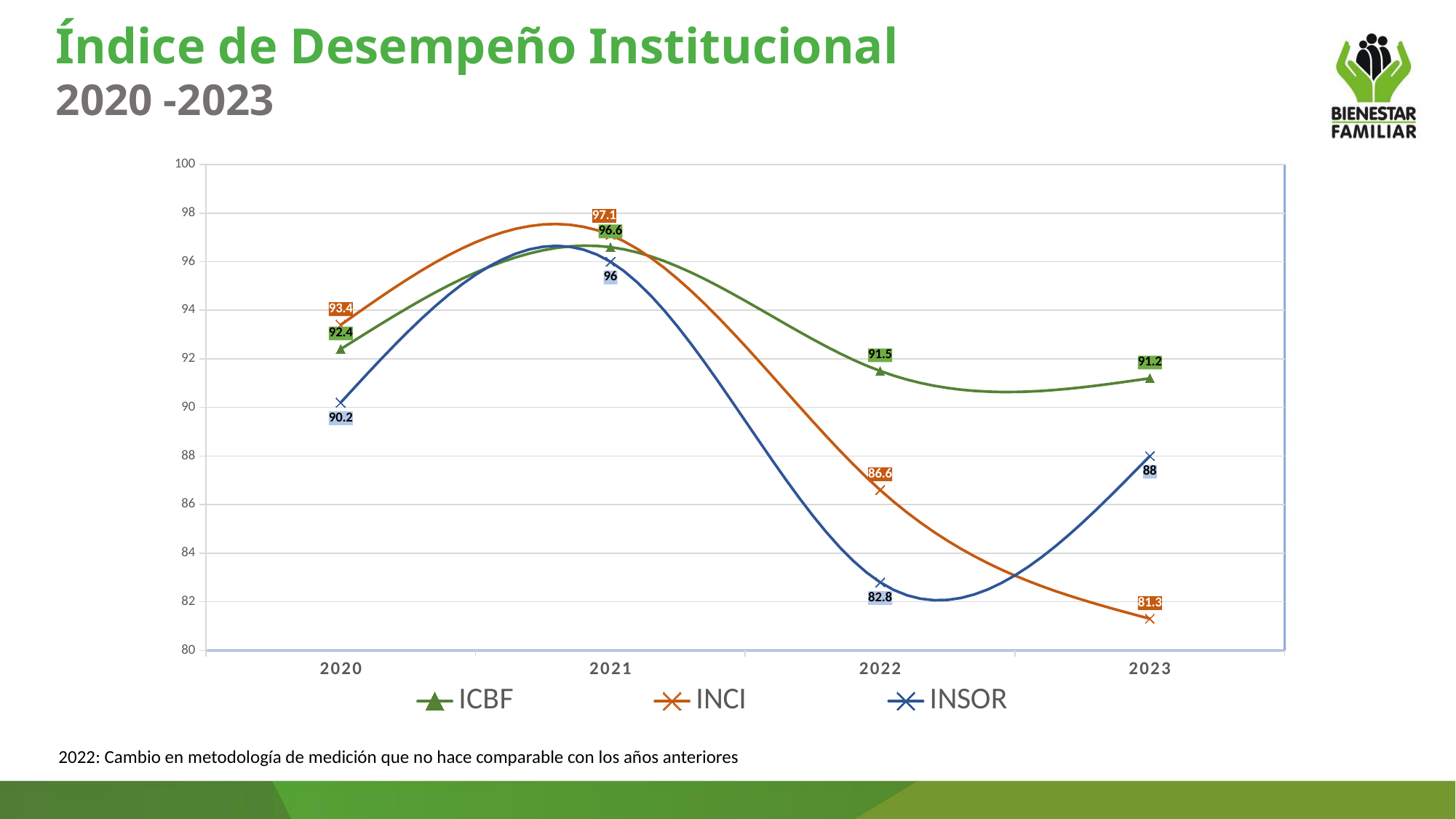
What is the value for INSOR in 2020? 90.2 Which is larger in 2023, the value for INSOR or the value for INCI? INSOR Which series has the lowest value in 2022? INSOR What is the value for INCI in 2022? 86.6 Which series has the highest value in 2021? INCI Does the INCI series rise or fall from 2021 to 2023? Fall What kind of chart is shown on the slide? Line chart How many years are shown on the x axis? 4 What is the value for INCI in 2023? 81.3 What is the value for ICBF in 2021? 96.6 How many series does the legend list? 3 What is the difference between the INCI value in 2021 and the INCI value in 2023? 15.8